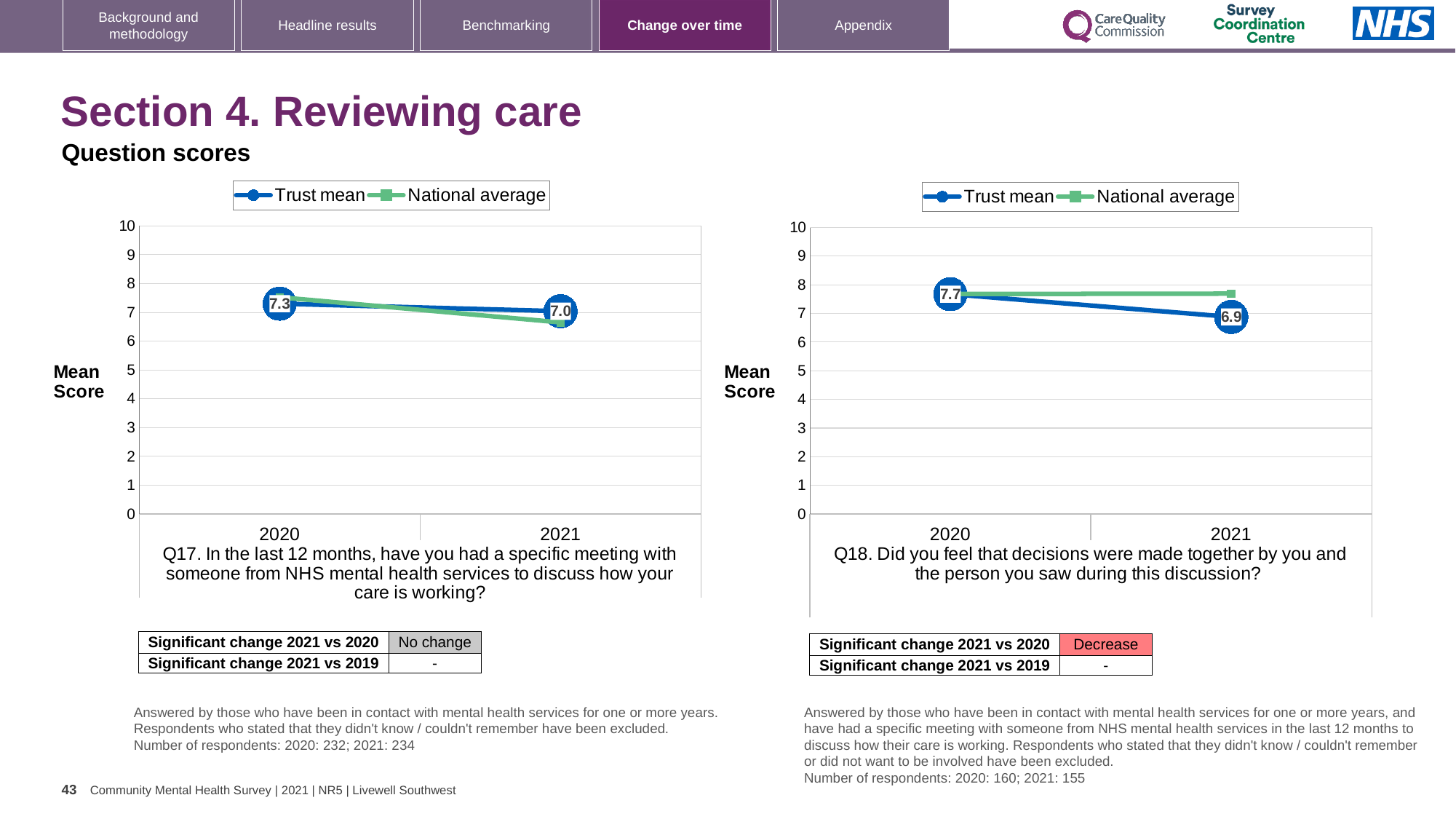
In the Q18 chart on the right, does the Trust mean rise or fall from 2020 to 2021? fall How many series does the legend of the Q18 chart on the right list? 2 In the Q18 chart on the right, is the National average for 2021 greater or less than 7? greater In the Q18 chart on the right, what is the Trust mean score for 2020? 7.7 How many years are shown on the x axis of the Q17 chart on the left? 2 In the Q17 chart on the left, what is the Trust mean score for 2021? 7.0 In the Q17 chart on the left, what is the Trust mean score for 2020? 7.3 In the Q18 chart on the right, what is the Trust mean score for 2021? 6.9 In the Q17 chart on the left, what is the difference between the Trust mean in 2020 and in 2021? 0.3 In the Q18 chart on the right, by how much did the Trust mean fall from 2020 to 2021? 0.8 In the Q18 chart on the right, which is larger in 2021, the Trust mean or the National average? National average What type of chart is the Q17 chart on the left? line chart